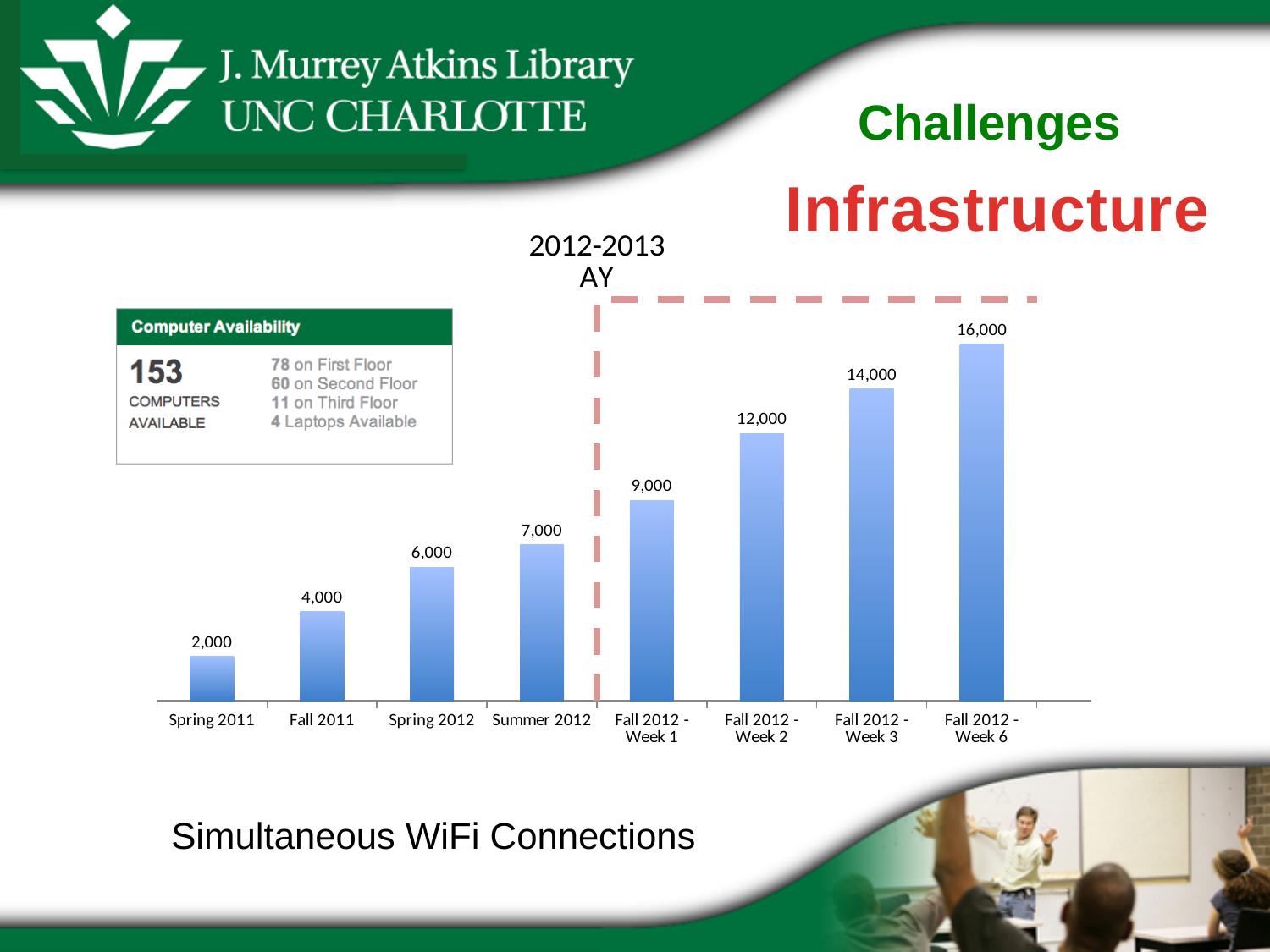
What is the value for Fall 2012 - Week 2 in the Simultaneous WiFi Connections chart? 12,000 Which is larger, the value for Fall 2012 - Week 3 or the value for Fall 2012 - Week 2? Fall 2012 - Week 3 Which category has the highest value in the Simultaneous WiFi Connections chart? Fall 2012 - Week 6 Which category has the lowest value in the Simultaneous WiFi Connections chart? Spring 2011 What is the difference between the values for Spring 2012 and Fall 2011? 2,000 What kind of chart is used to show Simultaneous WiFi Connections? Bar chart Do the values rise or fall from Spring 2011 to Fall 2012 - Week 6? Rise Which academic year is marked by the dashed box around the last four bars? 2012-2013 AY What is the difference between the values for Fall 2012 - Week 6 and Fall 2012 - Week 1? 7,000 What is the value for Spring 2011 in the Simultaneous WiFi Connections chart? 2,000 How many categories are shown on the x axis of the Simultaneous WiFi Connections chart? 8 What is the value for Summer 2012 in the Simultaneous WiFi Connections chart? 7,000